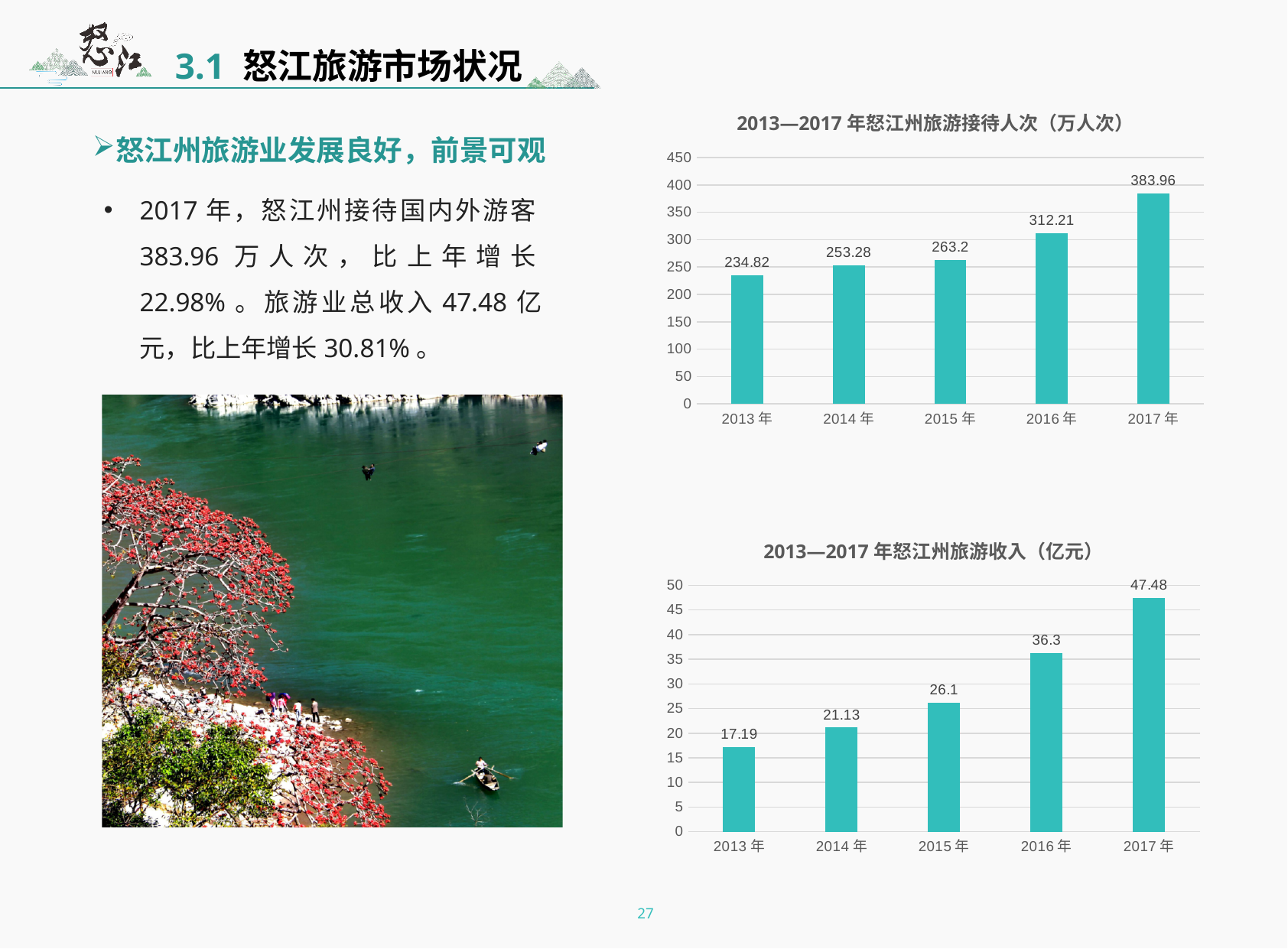
In the bottom chart (2013—2017 年怒江州旅游收入), what is the difference between the 2017 年 and 2016 年 values? 11.18 In the top chart (2013—2017 年怒江州旅游接待人次), what is the value for 2013 年? 234.82 In the bottom chart (2013—2017 年怒江州旅游收入), which year has the lowest value? 2013 年 In the bottom chart (2013—2017 年怒江州旅游收入), what is the value for 2017 年? 47.48 In the top chart (2013—2017 年怒江州旅游接待人次), what is the value for 2016 年? 312.21 In the top chart (2013—2017 年怒江州旅游接待人次), how many years are plotted? 5 In the bottom chart (2013—2017 年怒江州旅游收入), which is larger, the value for 2014 年 or 2016 年? 2016 年 What kind of chart is the bottom chart (2013—2017 年怒江州旅游收入)? bar chart In the top chart (2013—2017 年怒江州旅游接待人次), what is the difference between the 2017 年 and 2016 年 values? 71.75 In the top chart (2013—2017 年怒江州旅游接待人次), do the values rise or fall from 2013 年 to 2017 年? rise In the bottom chart (2013—2017 年怒江州旅游收入), what is the value for 2015 年? 26.1 In the top chart (2013—2017 年怒江州旅游接待人次), which year has the highest value? 2017 年